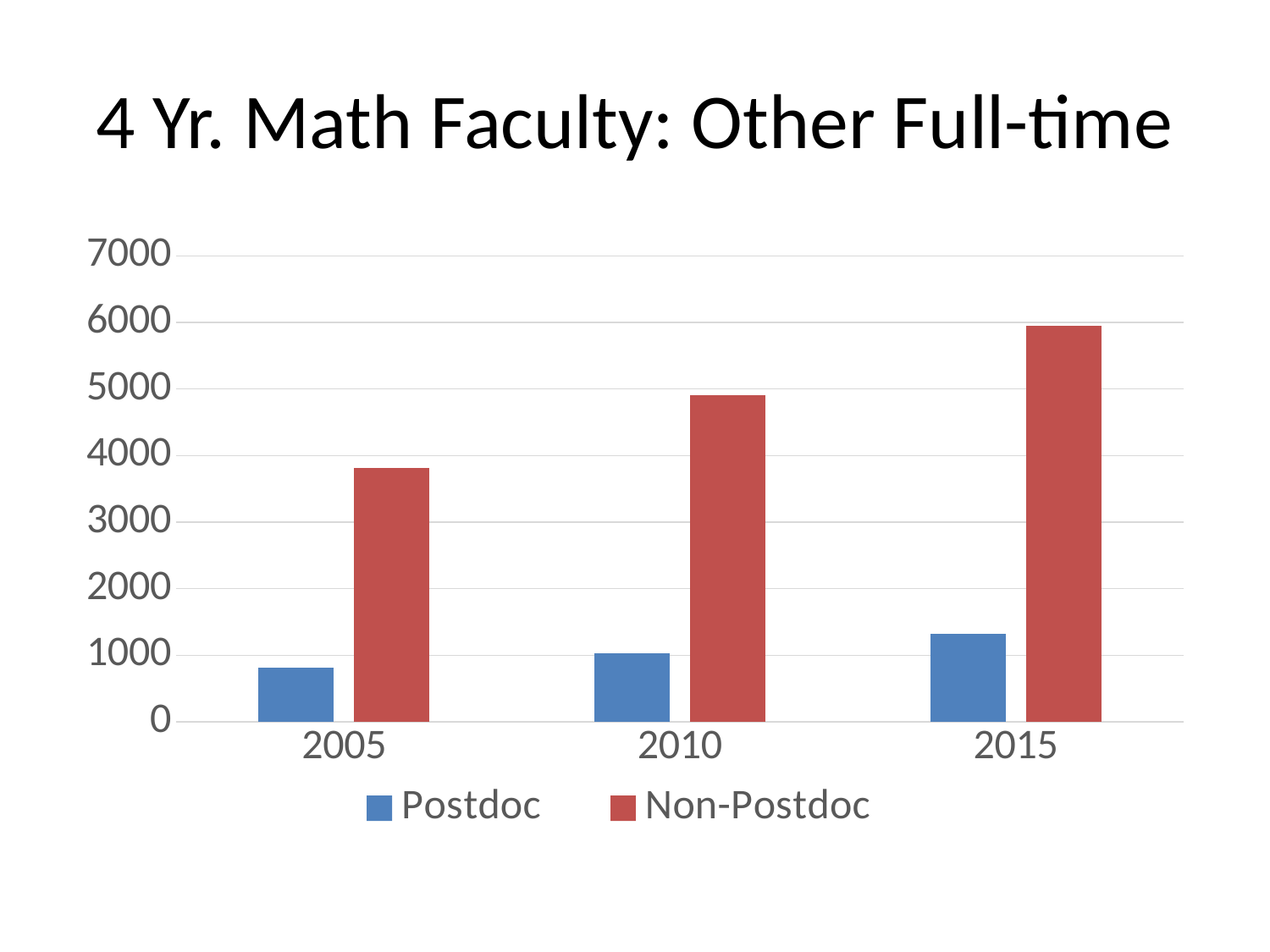
Which year has the lowest Postdoc value? 2005 Which is larger in 2010, the Postdoc value or the Non-Postdoc value? Non-Postdoc How many series does the legend list? 2 Is the Non-Postdoc value for 2005 greater or less than 4000? less What is the title of the chart? 4 Yr. Math Faculty: Other Full-time Is the Non-Postdoc value for 2015 greater or less than 5000? greater What kind of chart is shown on the slide? bar chart How many years are shown on the x axis? 3 Is the Postdoc value for 2015 greater or less than 1000? greater Do the Non-Postdoc values rise or fall from 2005 to 2015? rise Which year has the highest Non-Postdoc value? 2015